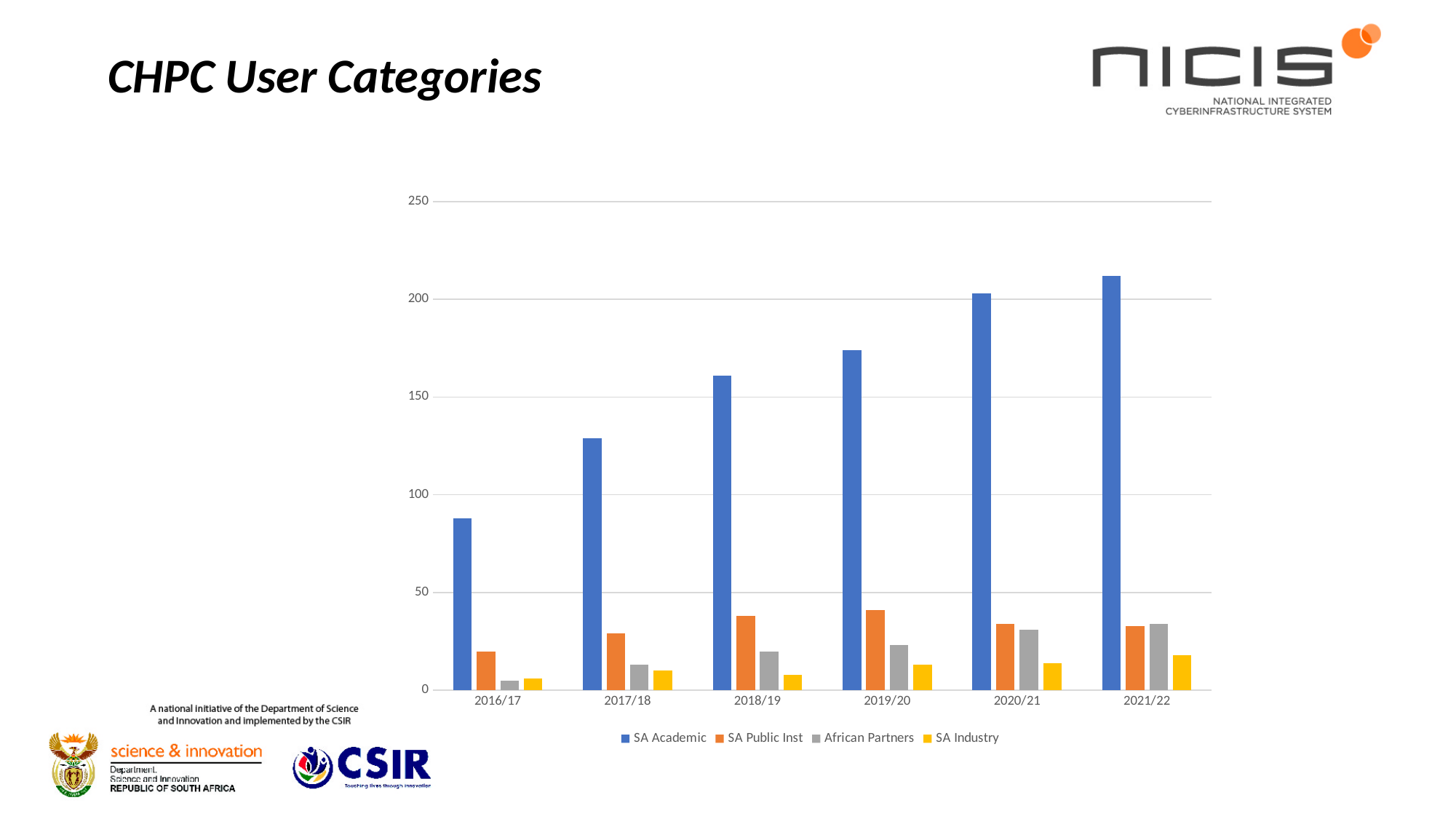
Is the SA Academic value for 2017/18 greater or less than 100? greater In which year is the SA Industry bar highest? 2021/22 In 2019/20, which is larger: SA Public Inst or SA Industry? SA Public Inst Is the SA Academic value for 2016/17 greater or less than 100? less Do the SA Academic values rise or fall from 2016/17 to 2021/22? Rise What is the title of the slide containing the chart? CHPC User Categories How many series does the legend list? 4 What kind of chart is shown on the slide? Bar chart How many year categories are shown on the x axis? 6 In which year is the SA Academic bar lowest? 2016/17 In which year is the SA Academic bar highest? 2021/22